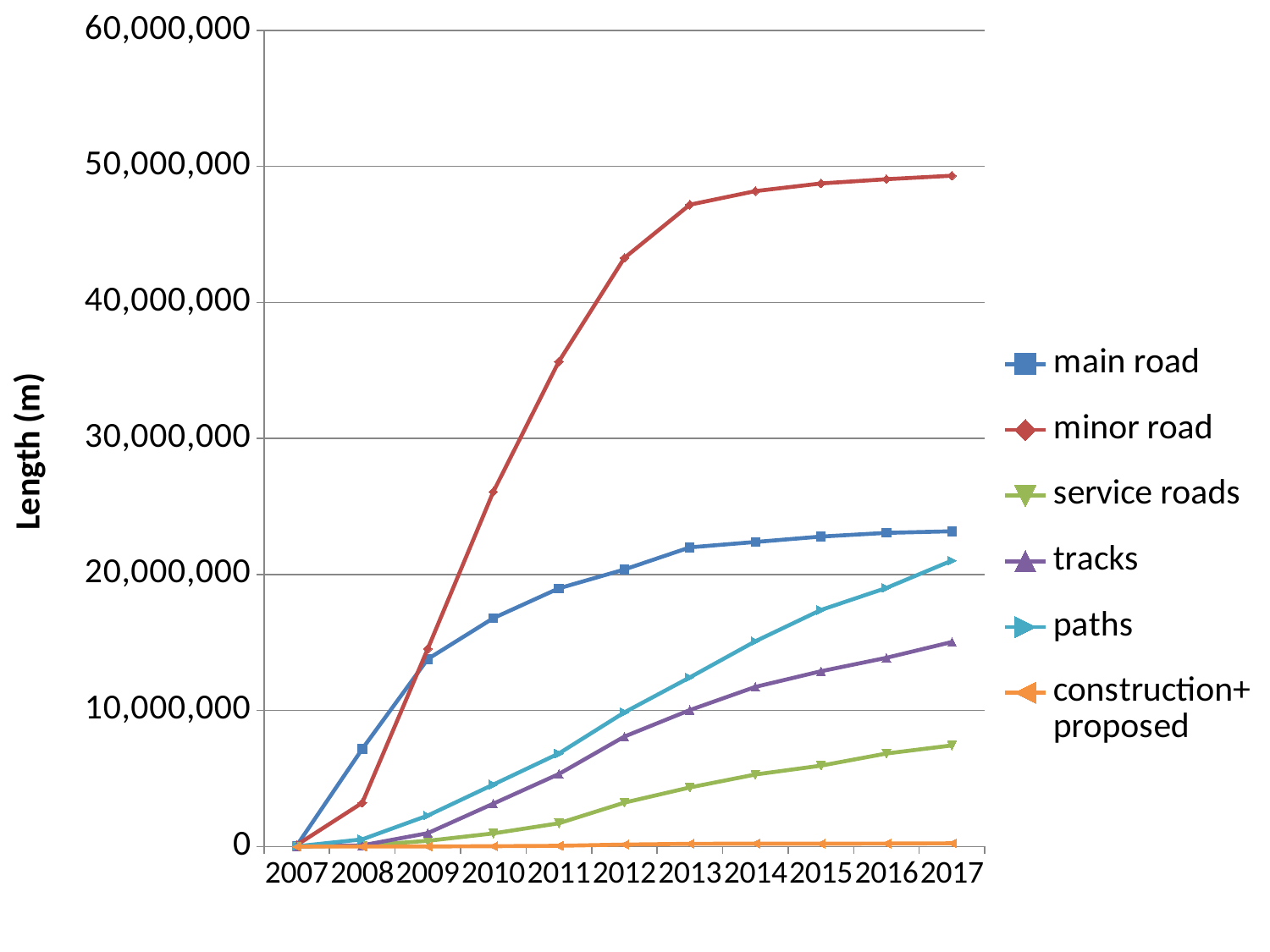
How many years are plotted along the x axis? 11 What kind of chart is shown on the slide? line chart Is the value for service roads in 2017 greater or less than 10,000,000? less Is the value for minor road in 2017 greater or less than 40,000,000? greater How many series does the legend list? 6 In 2017, which is larger: main road or paths? main road Which series has the lowest value in 2017? construction+proposed What is the label on the y axis? Length (m) Is the value for main road in 2017 greater or less than 20,000,000? greater Which series has the highest value in 2017? minor road In 2012, which is larger: minor road or main road? minor road Does the minor road series rise or fall from 2007 to 2017? rise